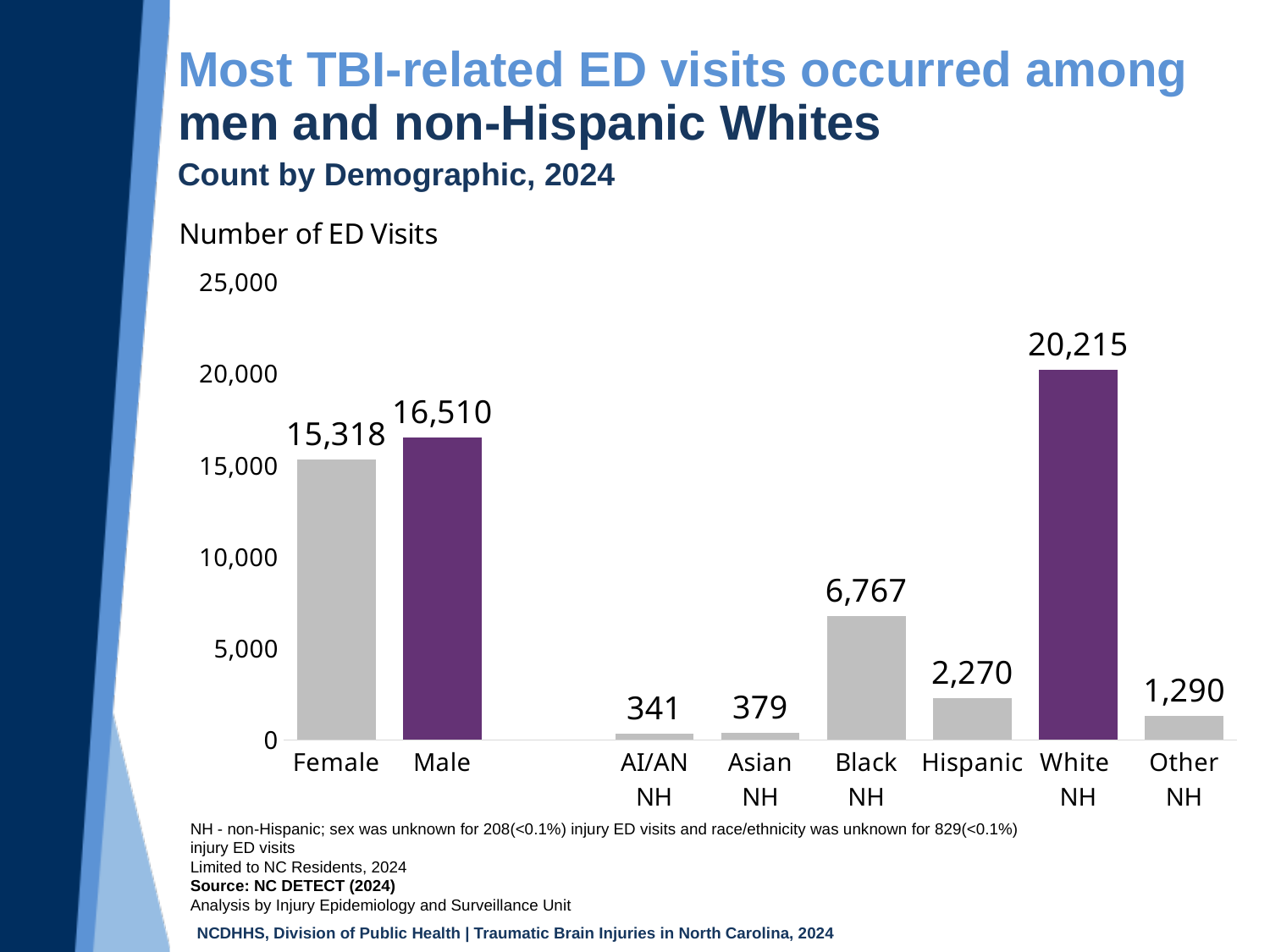
What is the difference in ED visits between White NH and Black NH? 13,448 Which has more ED visits, Hispanic or Other NH? Hispanic What is the difference in ED visits between Male and Female? 1,192 What is the number of ED visits for Hispanic? 2,270 Which category has the highest number of ED visits? White NH What is the subtitle of the chart? Count by Demographic, 2024 Which category has the lowest number of ED visits? AI/AN NH What is the number of ED visits for Male? 16,510 How many categories are shown on the x axis? 8 What is the number of ED visits for Black NH? 6,767 Is the value for Female greater or less than 15,000? greater What kind of chart is shown on the slide? Bar chart